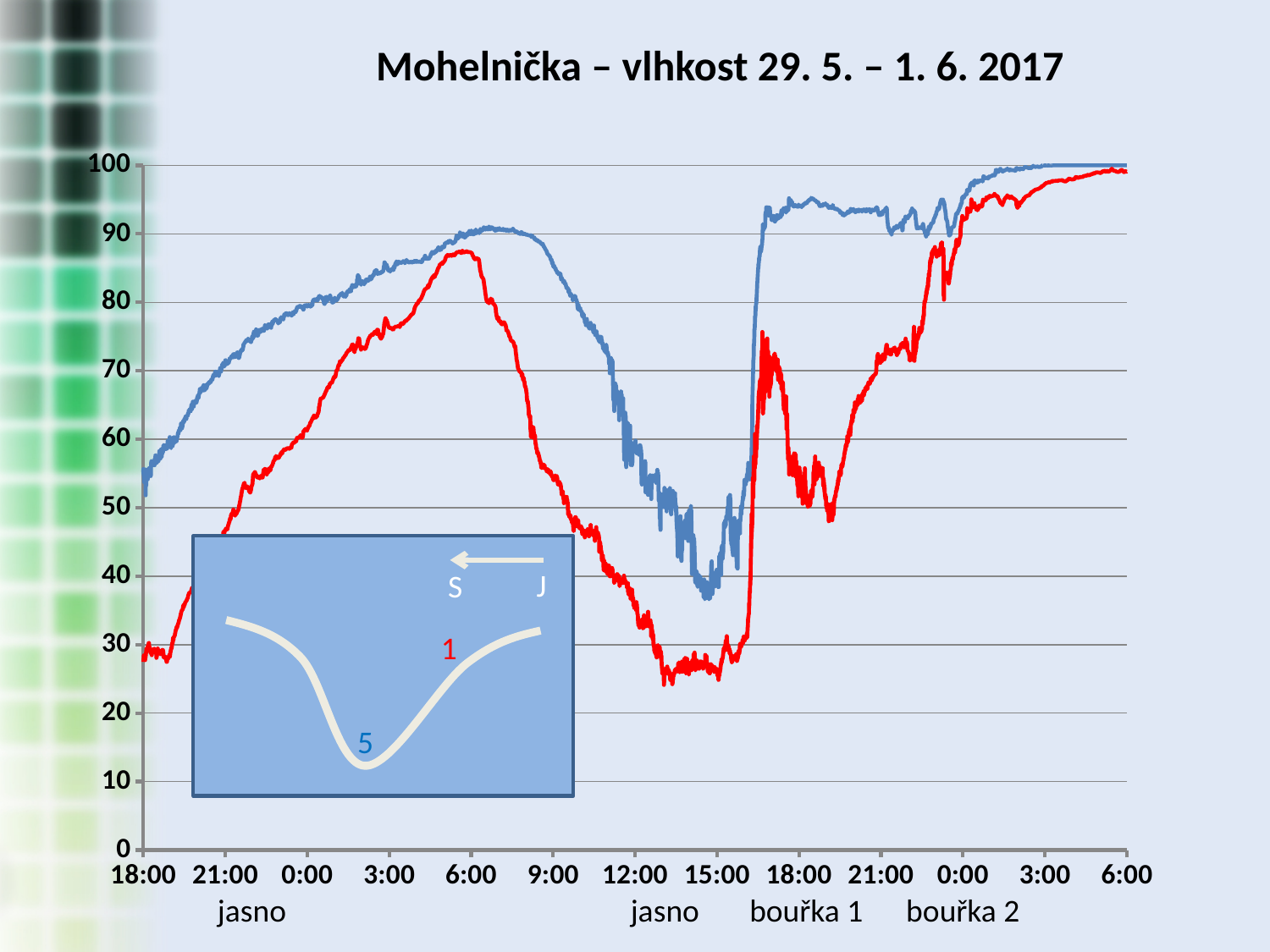
Is the lowest value of the red line (around 15:00) greater or less than 30? less Is the value of the red line at the start of the chart (18:00) greater or less than 40? less Is the lowest value of the blue line (around 15:00) greater or less than 50? less What are the two storm labels written below the x axis? bouřka 1 and bouřka 2 Do the values of both lines rise or fall between 18:00 and 6:00 on the first night? rise What is the title of the chart? Mohelnička – vlhkost 29. 5. – 1. 6. 2017 Which line drops to a lower minimum value, the red line or the blue line? the red line Which line is higher at 12:00, the red line or the blue line? the blue line How many lines are plotted on the chart? 2 What kind of chart is shown on the slide? line chart